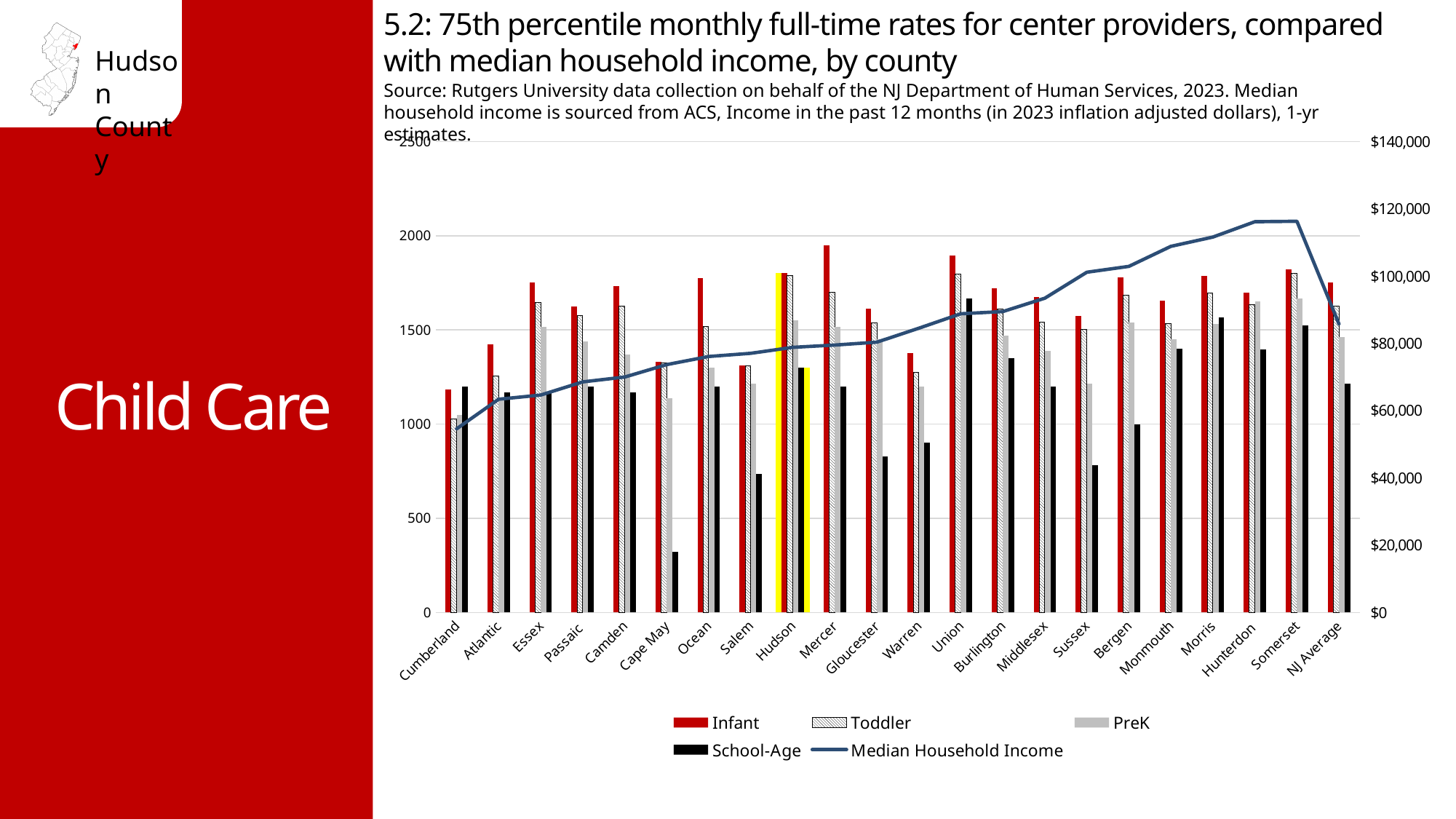
Which county has the lowest School-Age rate? Cape May Is the Median Household Income for Somerset greater or less than $100,000? greater Is the Median Household Income for Cumberland greater or less than $60,000? less Which is larger, the Infant rate for Essex or the Infant rate for Atlantic? Essex Is the Infant value for Mercer greater or less than 1500? greater Which county has the lowest Infant rate? Cumberland What kind of chart is this? Bar chart with a line Which county's bars are highlighted in yellow? Hudson How many series does the legend list? 5 How many counties (including NJ Average) are shown on the x axis? 22 Which county has the highest Infant rate? Mercer